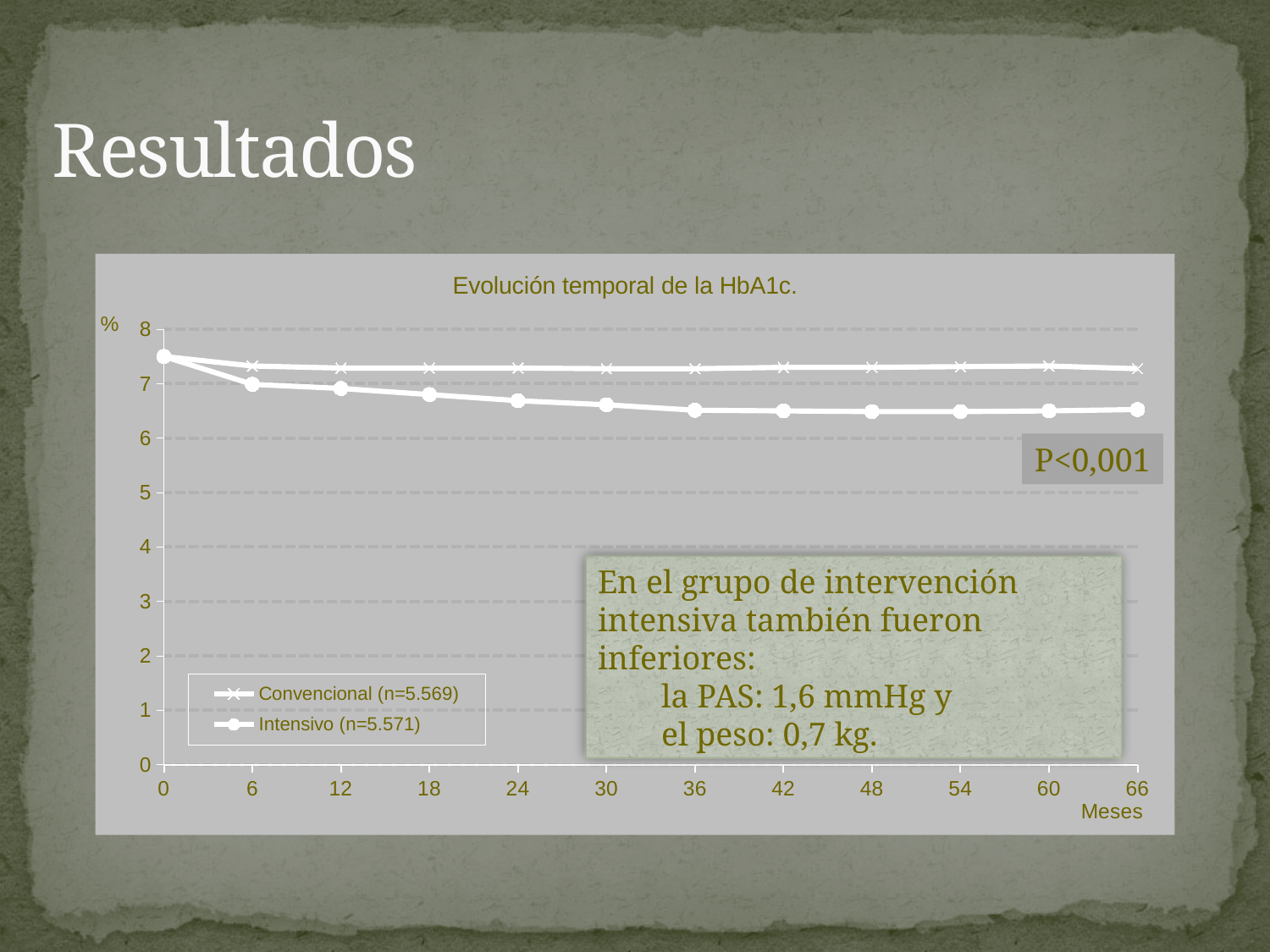
How many series does the legend list? 2 What is the title of the chart? Evolución temporal de la HbA1c. Does the Intensivo (n=5.571) series rise or fall between 0 and 36 months? fall Is the value for Convencional (n=5.569) at 30 months greater or less than 8? less Is the value for Intensivo (n=5.571) at 0 months greater or less than 7? greater How many time points are plotted along the x axis for each series? 12 Which series has the lower value at 66 months? Intensivo (n=5.571) What is the label of the x axis? Meses What kind of chart is shown on the slide? line chart Is the value for Convencional (n=5.569) at 66 months greater or less than 7? greater At 48 months, which series has the higher value, Convencional (n=5.569) or Intensivo (n=5.571)? Convencional (n=5.569)